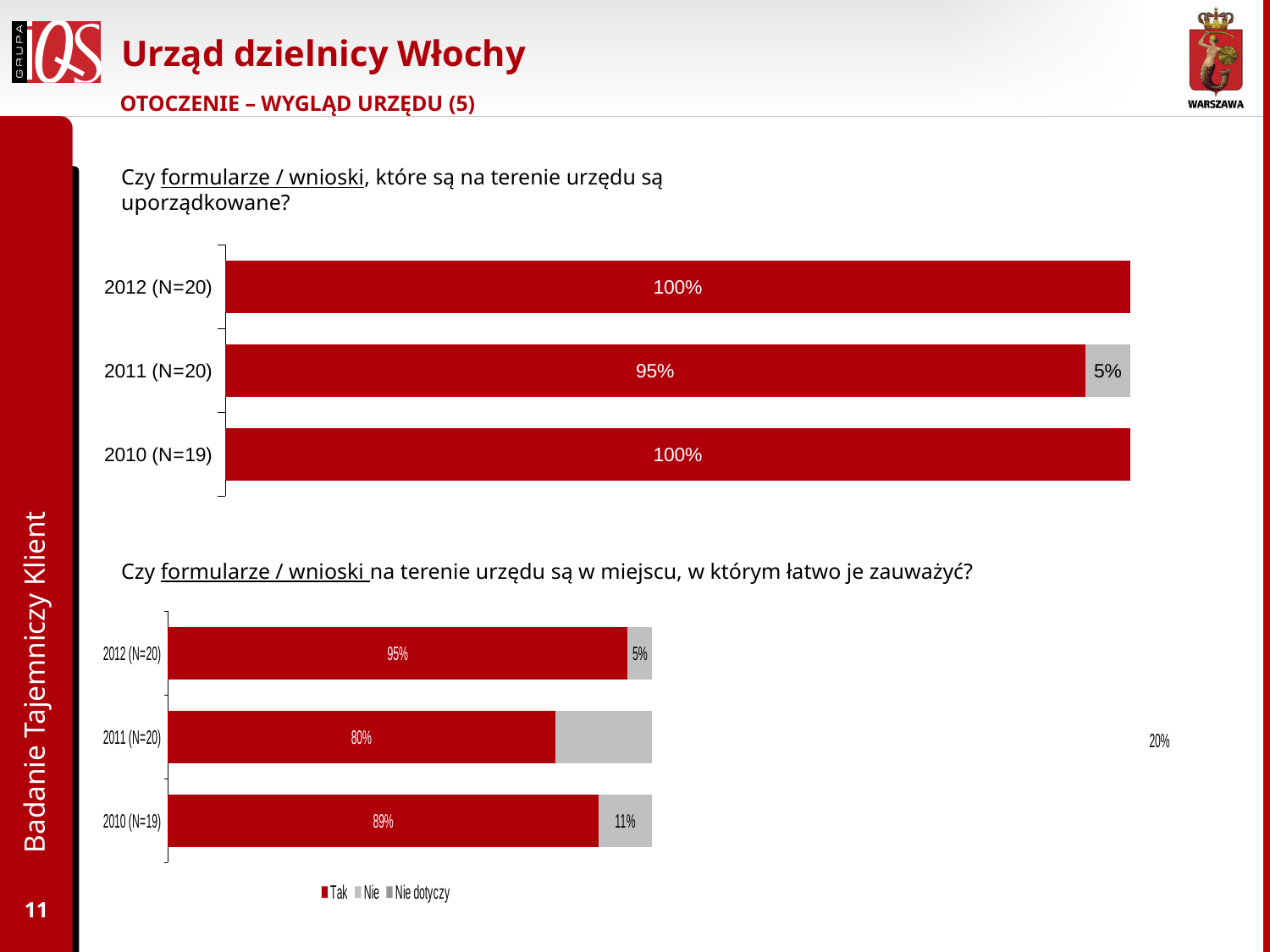
In the bottom chart ("Czy formularze / wnioski na terenie urzędu są w miejscu, w którym łatwo je zauważyć?"), what is the difference between the red (Tak) values for 2012 (N=20) and 2011 (N=20)? 15% In the bottom chart ("Czy formularze / wnioski na terenie urzędu są w miejscu, w którym łatwo je zauważyć?"), what is the grey segment value for 2010 (N=19)? 11% In the bottom chart ("Czy formularze / wnioski na terenie urzędu są w miejscu, w którym łatwo je zauważyć?"), which year has the highest red (Tak) value? 2012 (N=20) In the top chart ("Czy formularze / wnioski, które są na terenie urzędu są uporządkowane?"), how many year categories are shown? 3 How many series does the legend of the bottom chart list? 3 In the top chart ("Czy formularze / wnioski, które są na terenie urzędu są uporządkowane?"), what is the value of the red (Tak) segment for 2012 (N=20)? 100% In the bottom chart ("Czy formularze / wnioski na terenie urzędu są w miejscu, w którym łatwo je zauważyć?"), is the red (Tak) value larger for 2010 (N=19) or 2011 (N=20)? 2010 (N=19) In the top chart ("Czy formularze / wnioski, które są na terenie urzędu są uporządkowane?"), what is the value of the grey segment for 2011 (N=20)? 5% What type of chart is used on this slide? Bar chart In the bottom chart ("Czy formularze / wnioski na terenie urzędu są w miejscu, w którym łatwo je zauważyć?"), what is the red (Tak) value for 2011 (N=20)? 80% In the top chart ("Czy formularze / wnioski, które są na terenie urzędu są uporządkowane?"), which year has the lowest red (Tak) value? 2011 (N=20) In the top chart ("Czy formularze / wnioski, które są na terenie urzędu są uporządkowane?"), what is the value of the red (Tak) segment for 2011 (N=20)? 95%